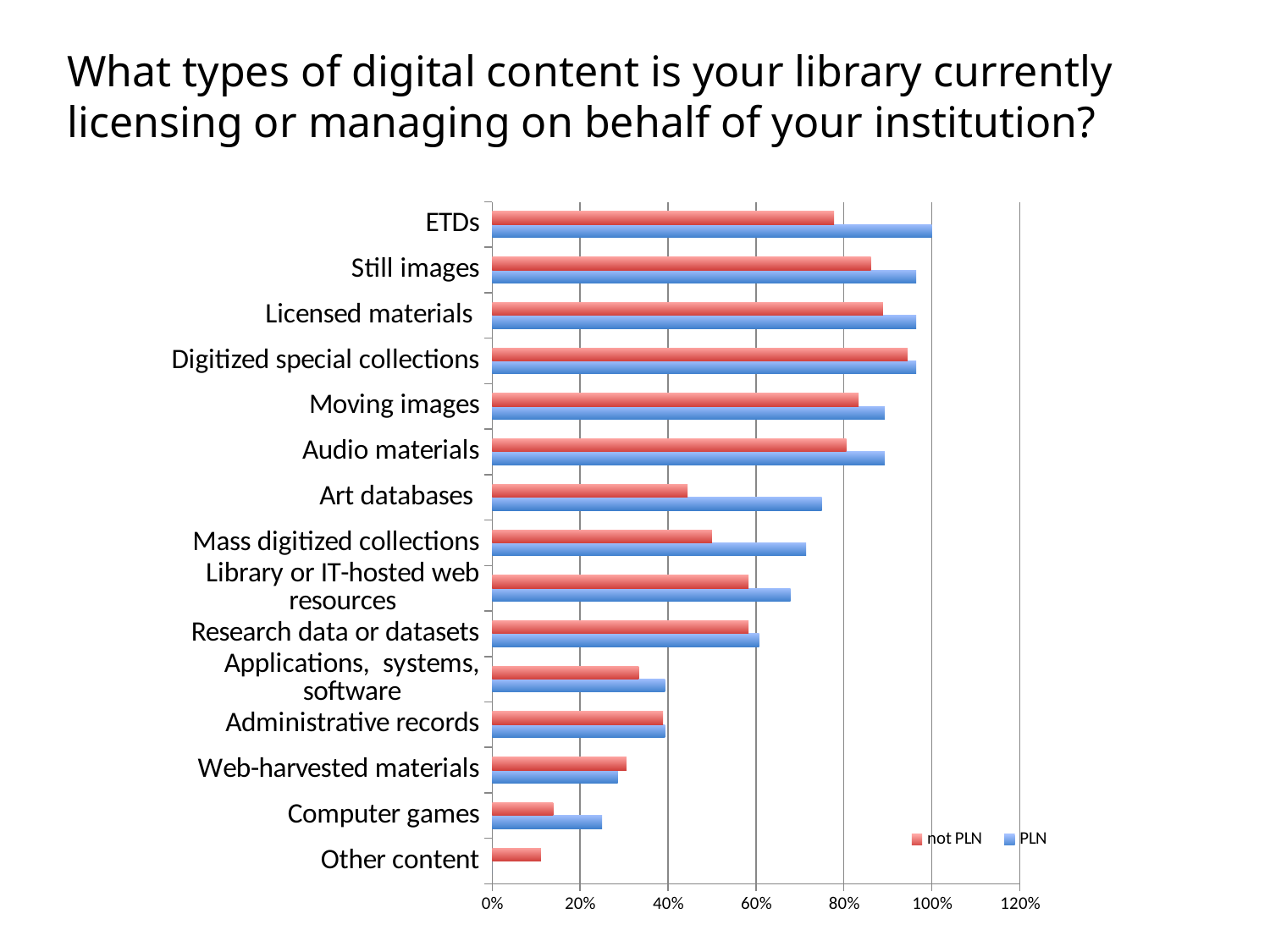
Is the PLN value for Mass digitized collections greater or less than 60%? greater How many series does the legend list? 2 What kind of chart is shown on the slide? bar chart Which category has the highest PLN value? ETDs Is the PLN value for Computer games greater or less than 20%? greater For Art databases, which is larger: the PLN value or the not PLN value? PLN What is the PLN value for ETDs? 100% Which colour represents the PLN series? blue Is the not PLN value for ETDs greater or less than 80%? less Which category has the lowest not PLN value? Other content How many content-type categories are plotted on the chart? 15 Which category has the highest not PLN value? Digitized special collections